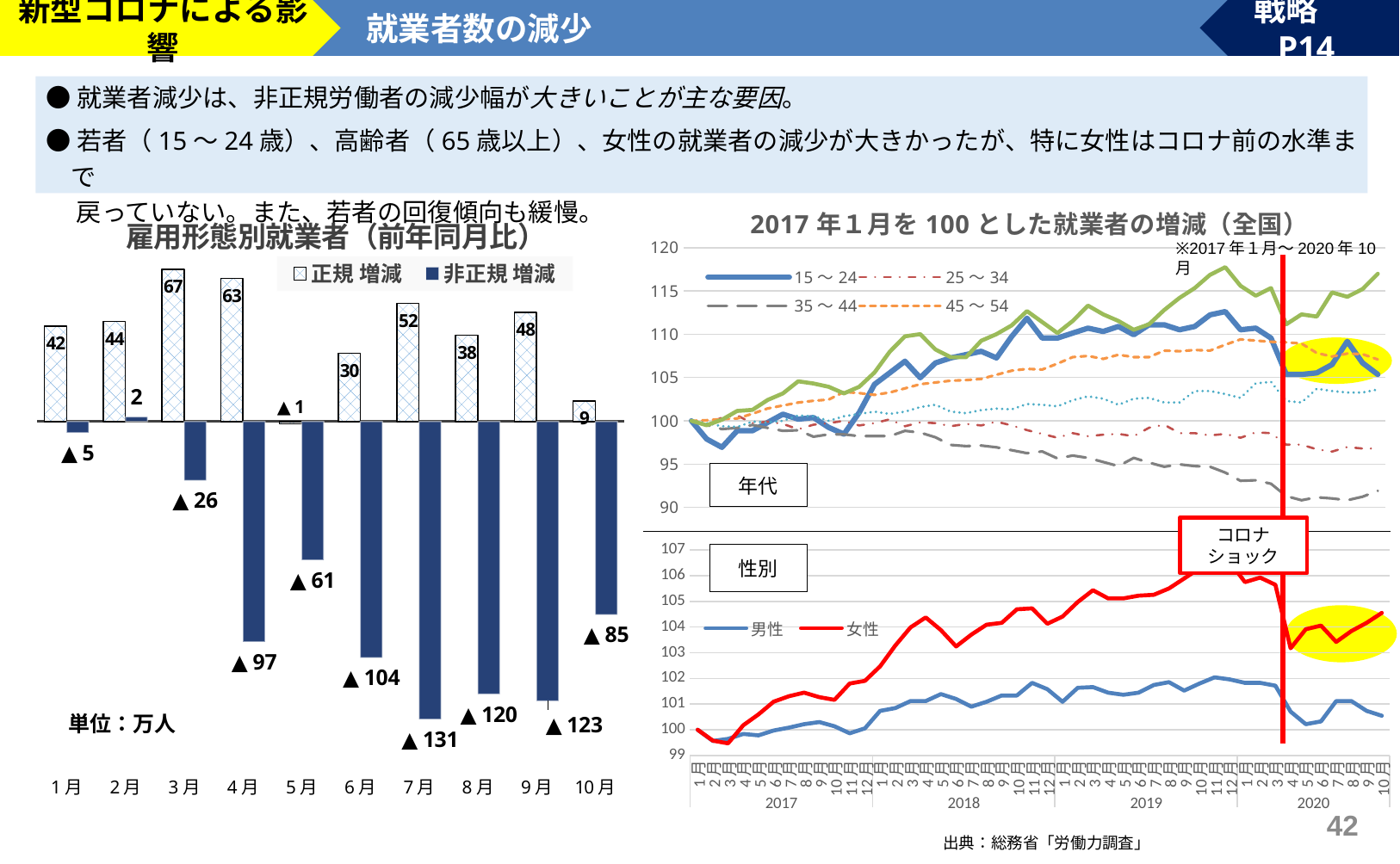
How many series does the legend of the 年代 line chart on the right list? 4 In the bar chart 雇用形態別就業者（前年同月比）, what is the value of 非正規 増減 for 10月? ▲85 In the bar chart 雇用形態別就業者（前年同月比）, which month has the lowest 非正規 増減 value? 7月 In the bar chart 雇用形態別就業者（前年同月比）, which is larger, the 正規 増減 value for 7月 or for 8月? 7月 In the bar chart 雇用形態別就業者（前年同月比）, what is the difference between the 正規 増減 values for 3月 and 4月? 4 In the bar chart 雇用形態別就業者（前年同月比）, what is the value of 非正規 増減 for 7月? ▲131 How many months are shown on the x axis of the bar chart 雇用形態別就業者（前年同月比）? 10 In the 性別 line chart on the right, is the value for 女性 in 10月 2020 greater or less than 104? greater In the bar chart 雇用形態別就業者（前年同月比）, which month has the highest 正規 増減 value? 3月 How many series does the legend of the bar chart 雇用形態別就業者（前年同月比） list? 2 What kind of chart is 雇用形態別就業者（前年同月比）? bar chart In the bar chart 雇用形態別就業者（前年同月比）, what is the value of 正規 増減 for 3月? 67